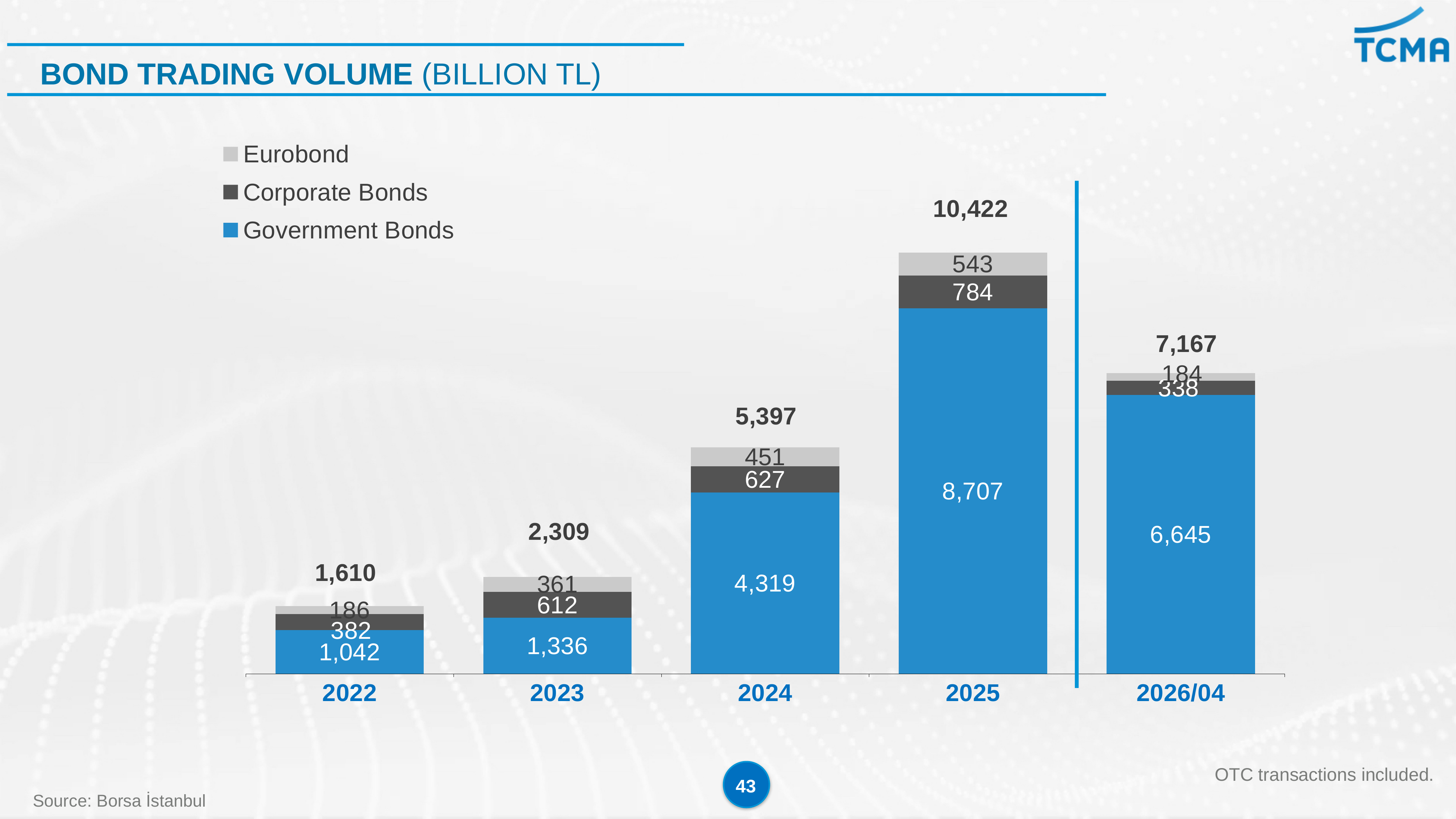
How many series does the legend list? 3 What is the Government Bonds trading volume in 2025? 8,707 What is the difference between the total bond trading volume in 2025 and in 2024? 5,025 What is the Eurobond trading volume in 2024? 451 What kind of chart is shown on the slide? Stacked bar chart What is the total bond trading volume shown for 2026/04? 7,167 How many periods are shown on the x axis? 5 Which is larger, the Corporate Bonds volume in 2024 or the Eurobond volume in 2025? Corporate Bonds volume in 2024 What is the Corporate Bonds trading volume in 2023? 612 Which period has the lowest total bond trading volume? 2022 Do the total bond trading volumes rise or fall from 2022 to 2025? Rise Which year has the highest total bond trading volume? 2025